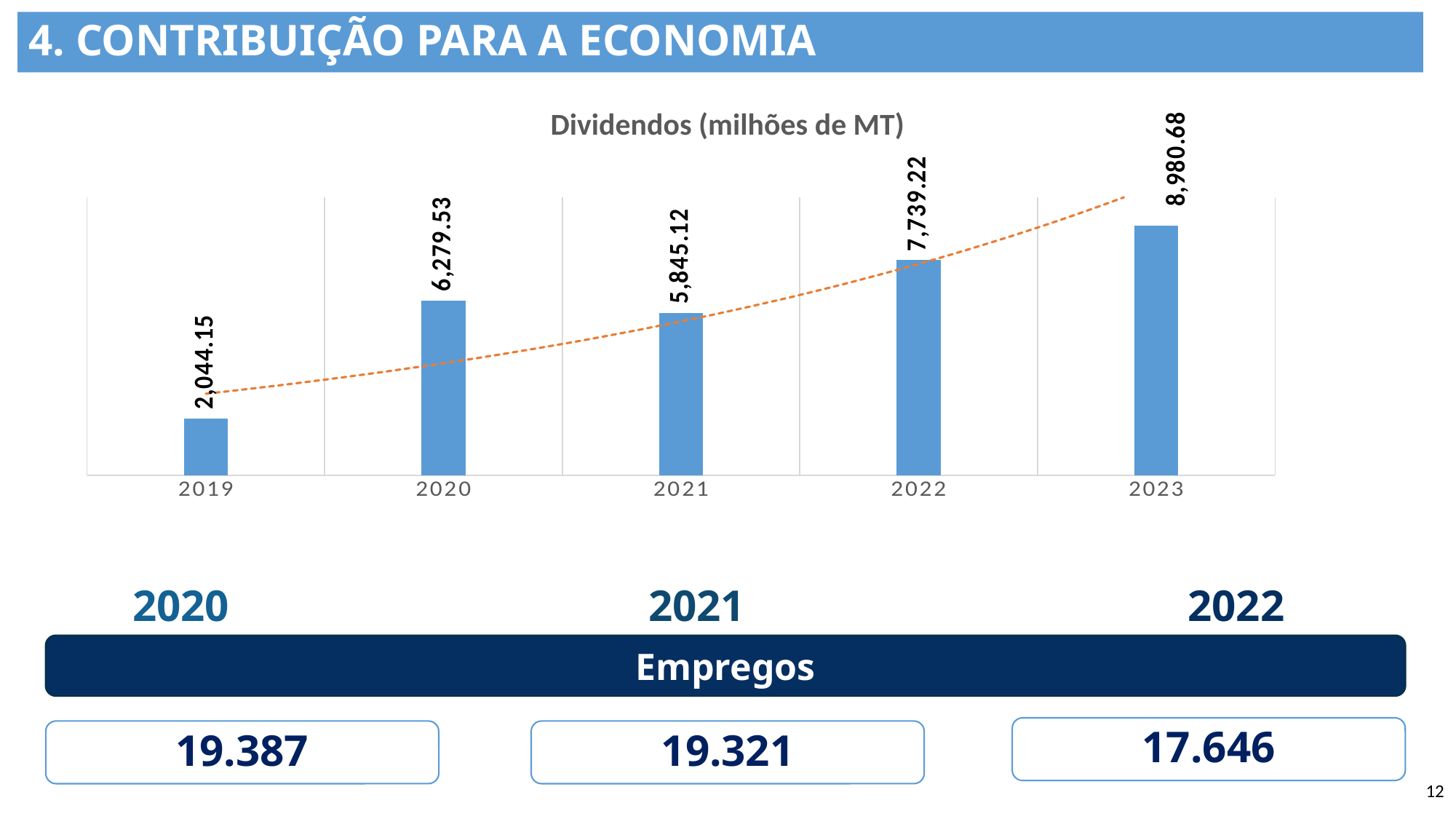
What is the difference between the Dividendos values for 2020 and 2019? 4,235.38 What is the value of the Dividendos bar for 2021? 5,845.12 What is the value of the Dividendos bar for 2019? 2,044.15 Which year has the larger Dividendos value, 2020 or 2021? 2020 What is the difference between the Dividendos values for 2023 and 2022? 1,241.46 Do the Dividendos values generally rise or fall from 2019 to 2023? rise Which year has the lowest Dividendos value? 2019 How many years are shown on the x axis of the Dividendos chart? 5 What kind of chart is used to show the Dividendos data? bar chart Which year has the highest Dividendos value? 2023 What is the value of the Dividendos bar for 2023? 8,980.68 What is the title of the chart on the slide? Dividendos (milhões de MT)